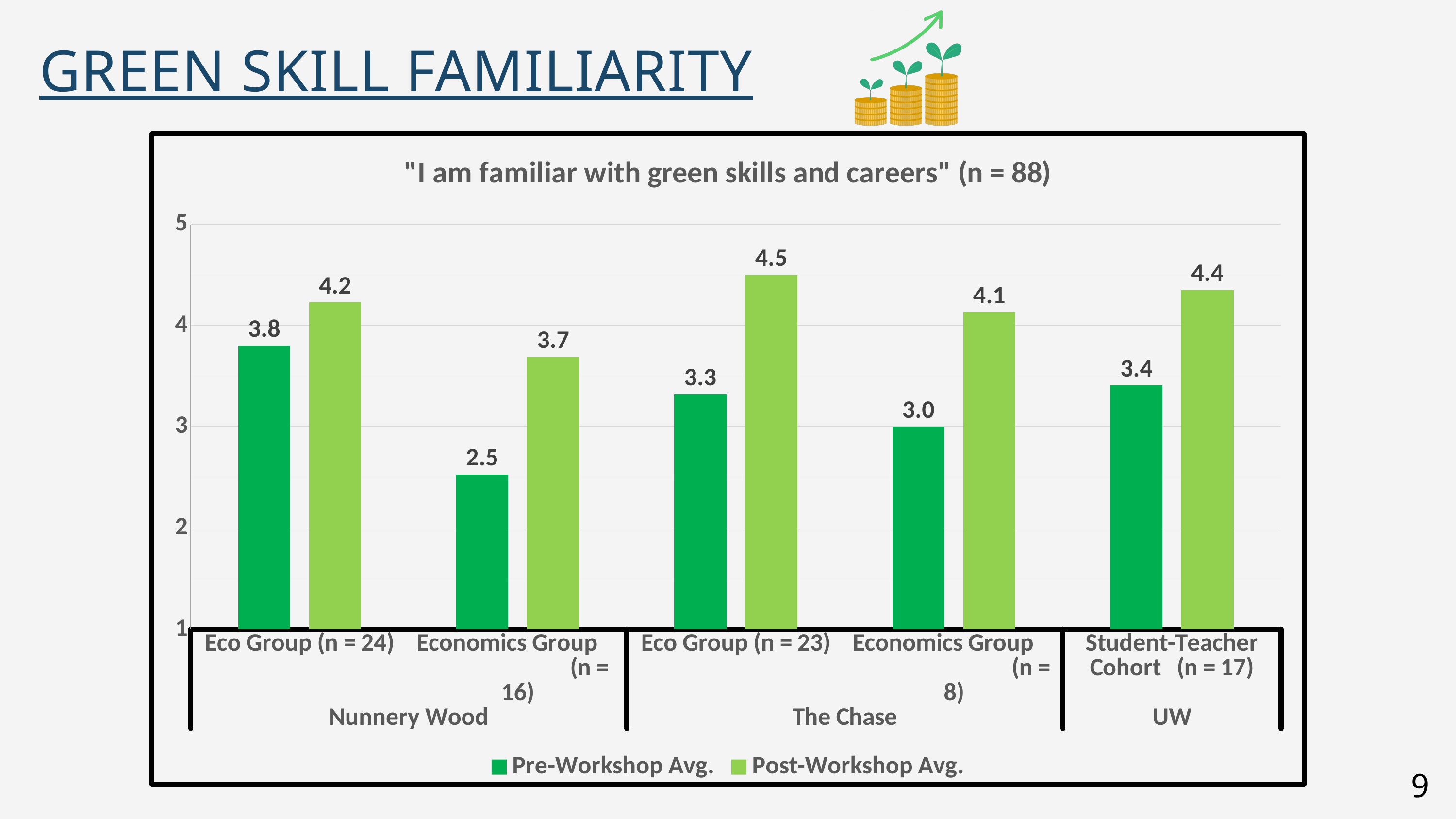
Which group has the highest Post-Workshop Avg.? Eco Group (n = 23), The Chase Is the Post-Workshop Avg. for The Chase Economics Group (n = 8) greater or less than 4? greater Which is larger: the Pre-Workshop Avg. for The Chase Economics Group (n = 8) or the Pre-Workshop Avg. for the UW Student-Teacher Cohort (n = 17)? UW Student-Teacher Cohort (n = 17) What is the difference between the Post-Workshop Avg. and Pre-Workshop Avg. for the Nunnery Wood Economics Group (n = 16)? 1.2 How many groups are shown on the x axis of the chart? 5 What is the Post-Workshop Avg. for The Chase Eco Group (n = 23)? 4.5 How many series does the legend list? 2 What is the Pre-Workshop Avg. for the UW Student-Teacher Cohort (n = 17)? 3.4 What is the title of the chart? "I am familiar with green skills and careers" (n = 88) Which group has the lowest Pre-Workshop Avg.? Economics Group (n = 16), Nunnery Wood What is the Pre-Workshop Avg. for the Nunnery Wood Eco Group (n = 24)? 3.8 What kind of chart is shown on the slide? Bar chart